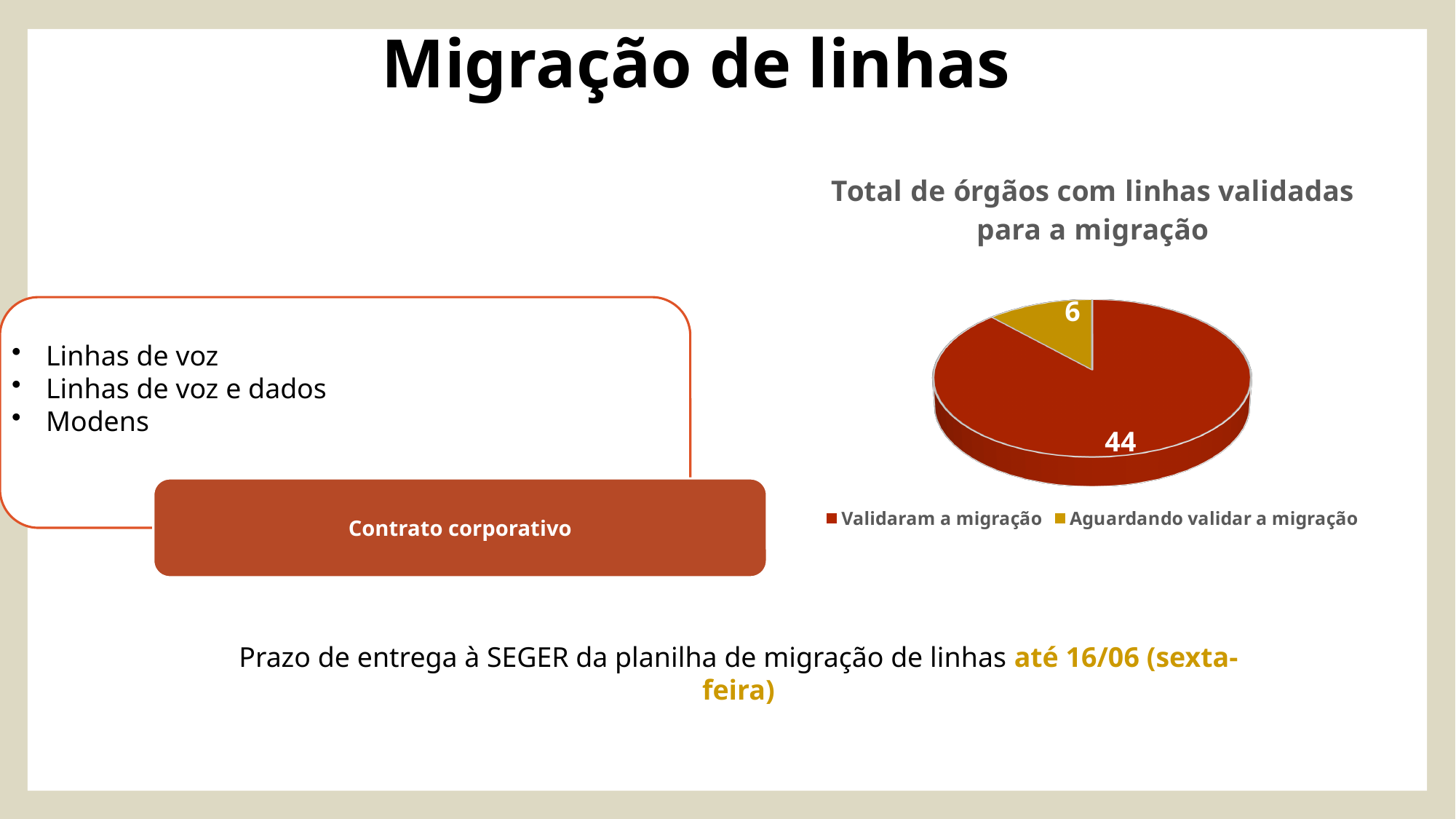
Which category has the largest slice of the pie? Validaram a migração What is the title of the chart? Total de órgãos com linhas validadas para a migração What is the value for "Validaram a migração"? 44 What is the value for "Aguardando validar a migração"? 6 Which is larger: "Validaram a migração" or "Aguardando validar a migração"? Validaram a migração What share of the pie does "Validaram a migração" represent? 88% How many slices does the pie chart have? 2 How many entries does the legend list? 2 What is the difference between the values for "Validaram a migração" and "Aguardando validar a migração"? 38 What type of chart is shown on the slide? Pie chart What is the total of all slices in the pie chart? 50 Which category has the smallest slice of the pie? Aguardando validar a migração